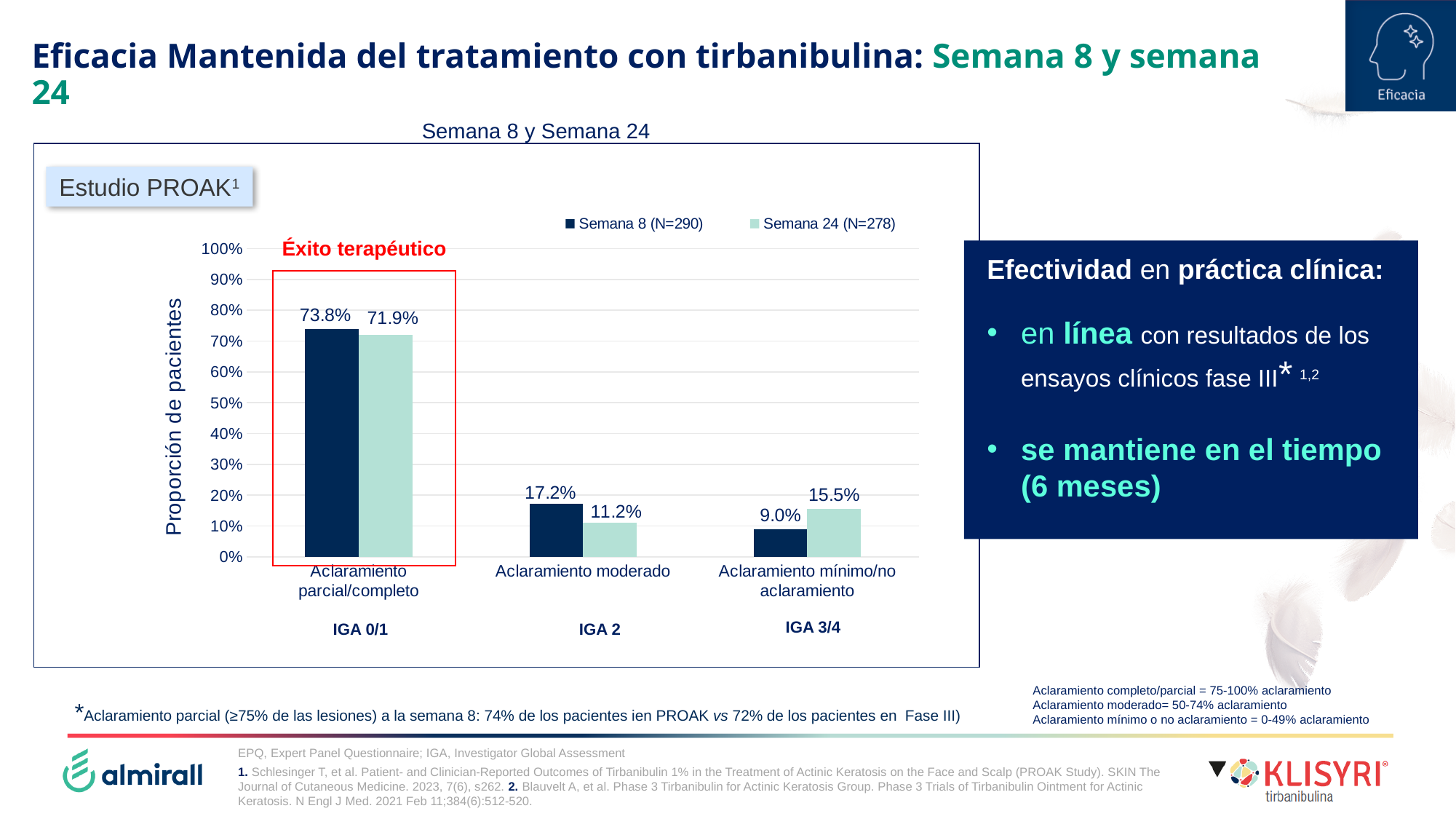
What is the value for Semana 24 in the Aclaramiento moderado (IGA 2) category? 11.2% What is the difference between the Semana 8 and Semana 24 values in the Aclaramiento parcial/completo category? 1.9% What is the value for Semana 8 in the Aclaramiento mínimo/no aclaramiento (IGA 3/4) category? 9.0% Which category has the lowest value for Semana 8? Aclaramiento mínimo/no aclaramiento How many categories are shown on the x axis of the chart? 3 How many series does the chart legend list? 2 Is the Semana 24 value for Aclaramiento moderado greater or less than 20%? less What kind of chart is shown on the slide? bar chart Which category has the highest value for Semana 24? Aclaramiento parcial/completo In the Aclaramiento mínimo/no aclaramiento category, which series has the larger value, Semana 8 or Semana 24? Semana 24 What is the value for Semana 8 in the Aclaramiento parcial/completo (IGA 0/1) category? 73.8% What is the label of the y axis of the chart? Proporción de pacientes